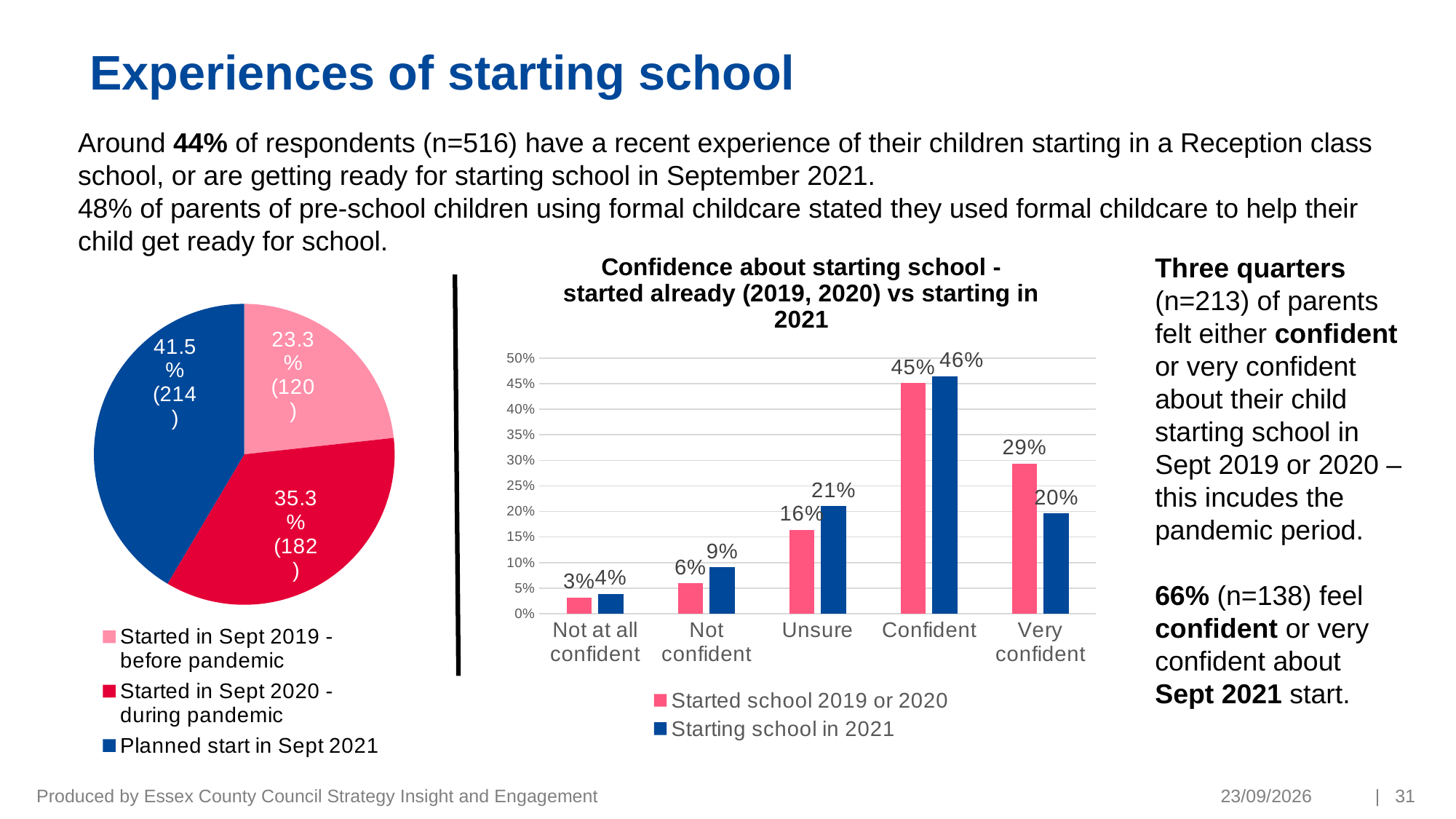
In the 'Confidence about starting school' chart, what is the value for Very confident in the 'Started school 2019 or 2020' series? 29% In the 'Confidence about starting school' chart, how many series does the legend list? 2 In the pie chart on the left, what share of respondents planned to start in Sept 2021? 41.5% In the pie chart on the left, how many respondents started in Sept 2020 - during pandemic? 182 In the 'Confidence about starting school' chart, what is the difference between the two series for Very confident? 9% In the 'Confidence about starting school' chart, what is the value for Unsure in the 'Starting school in 2021' series? 21% In the 'Confidence about starting school' chart, which series has the larger value for Not confident? Starting school in 2021 What kind of chart is the 'Confidence about starting school' chart? Bar chart In the pie chart on the left, how many categories are shown? 3 In the pie chart on the left, which category has the smallest slice? Started in Sept 2019 - before pandemic In the 'Confidence about starting school' chart, which category has the lowest value for the 'Started school 2019 or 2020' series? Not at all confident In the 'Confidence about starting school' chart, which category has the highest value for the 'Starting school in 2021' series? Confident